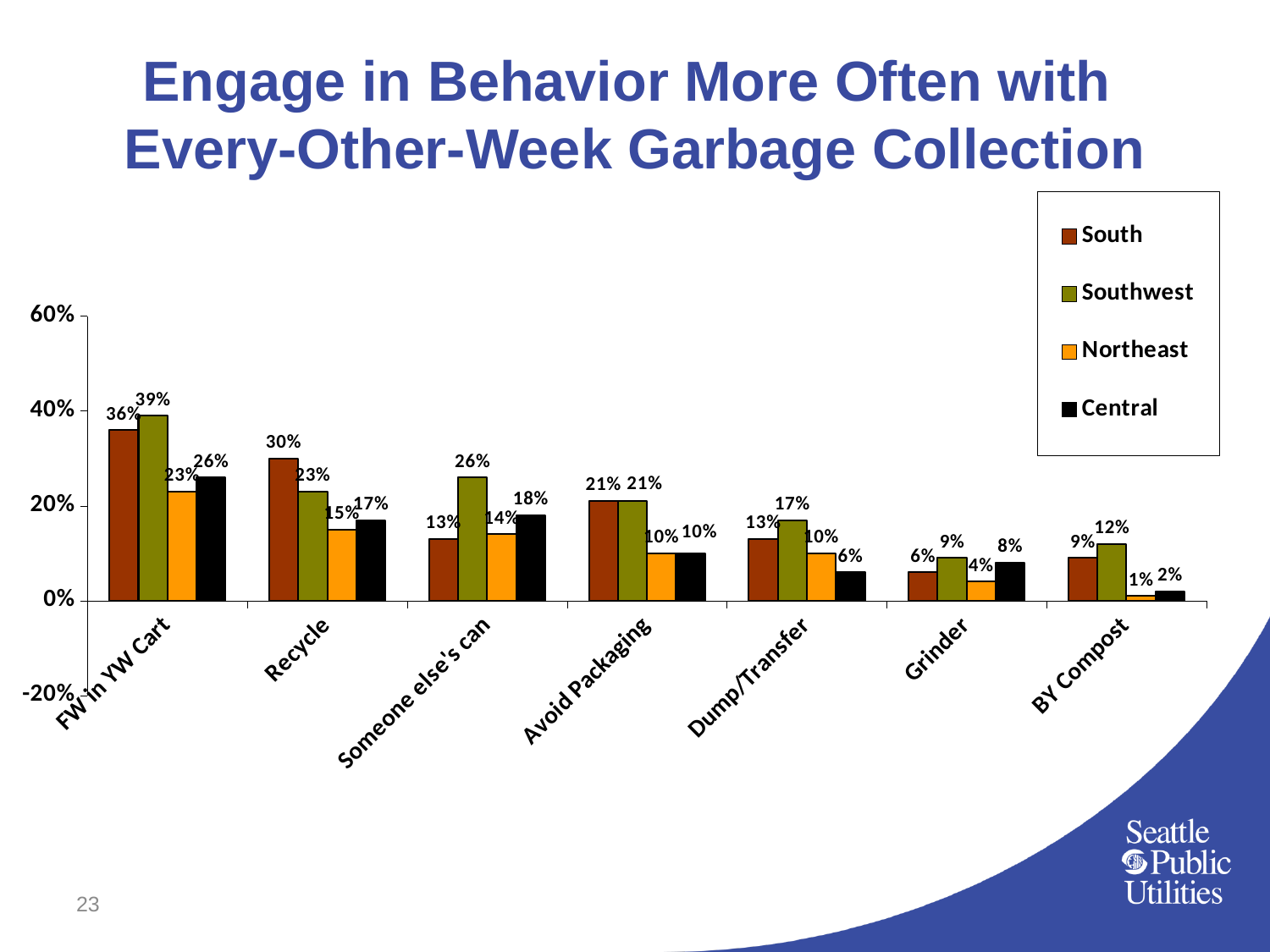
What is the value for Southwest in the FW in YW Cart category? 39% What is the difference between the Southwest and South values in the Someone else's can category? 13% What is the value for Northeast in the BY Compost category? 1% Which series is shown in black in the legend? Central What is the value for South in the Recycle category? 30% Is the value for Central in the Recycle category greater or less than 20%? less Which category has the lowest value for the Northeast series? BY Compost How many series does the legend list? 4 Which category has the highest value for the South series? FW in YW Cart In the Dump/Transfer category, which is larger, the Southwest value or the Central value? Southwest What kind of chart is shown on the slide? bar chart How many behavior categories are shown on the x axis? 7